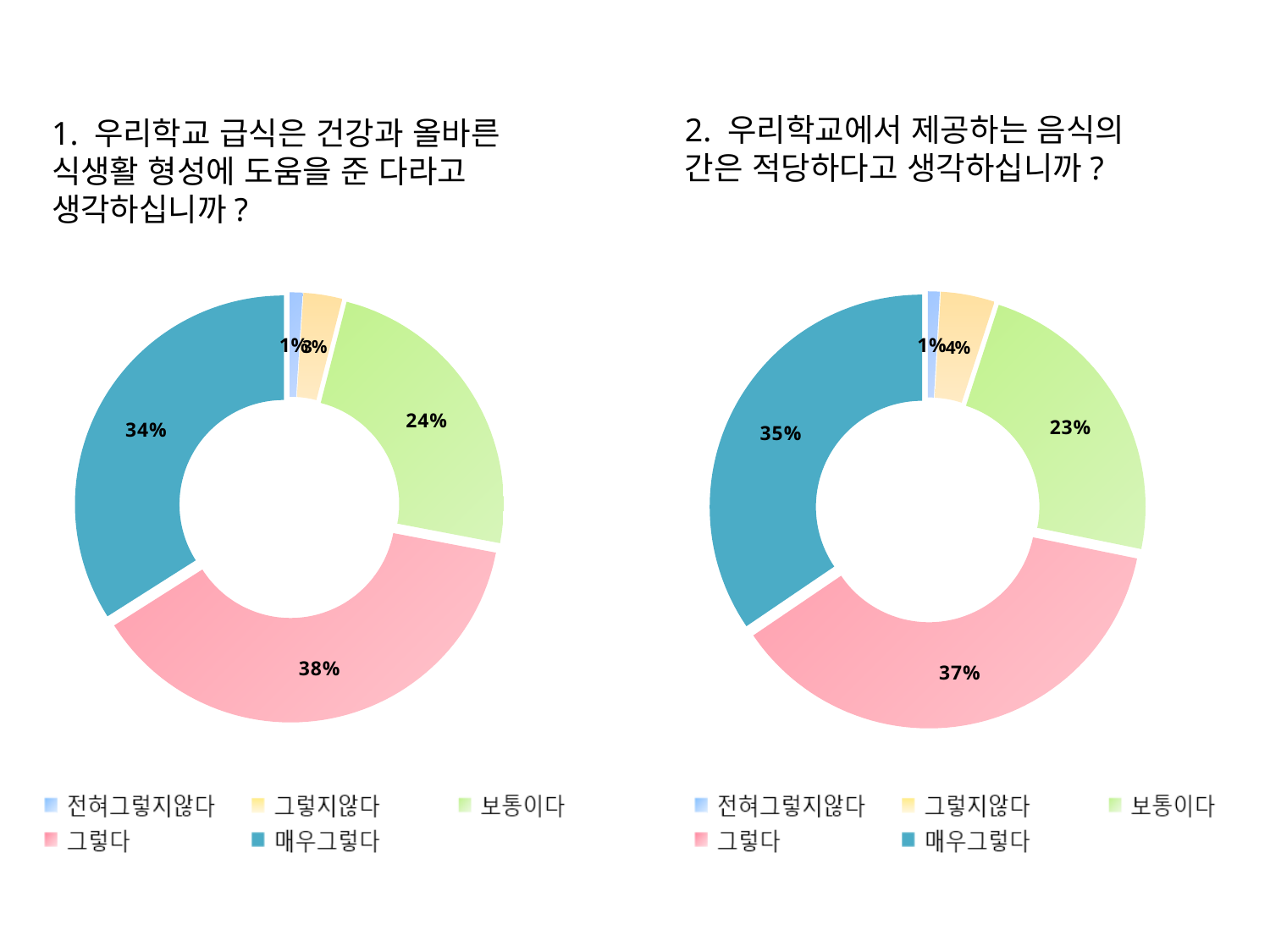
On the right chart, which is larger, the share for 보통이다 or the share for 매우그렇다? 매우그렇다 On the right chart, which category has the smallest share? 전혀그렇지않다 On the right chart, what percentage is shown for 매우그렇다? 35% On the left chart, what percentage is shown for 보통이다? 24% On the right chart, what percentage is shown for 그렇지않다? 4% On the right chart, what percentage is shown for 보통이다? 23% On the left chart, what percentage is shown for 매우그렇다? 34% What type of chart is the left chart? Doughnut chart On the left chart, what percentage is shown for 그렇다? 38% On the left chart, what is the difference between the shares for 그렇다 and 매우그렇다? 4% On the left chart, which category has the largest share? 그렇다 On the right chart, what percentage is shown for 그렇다? 37%